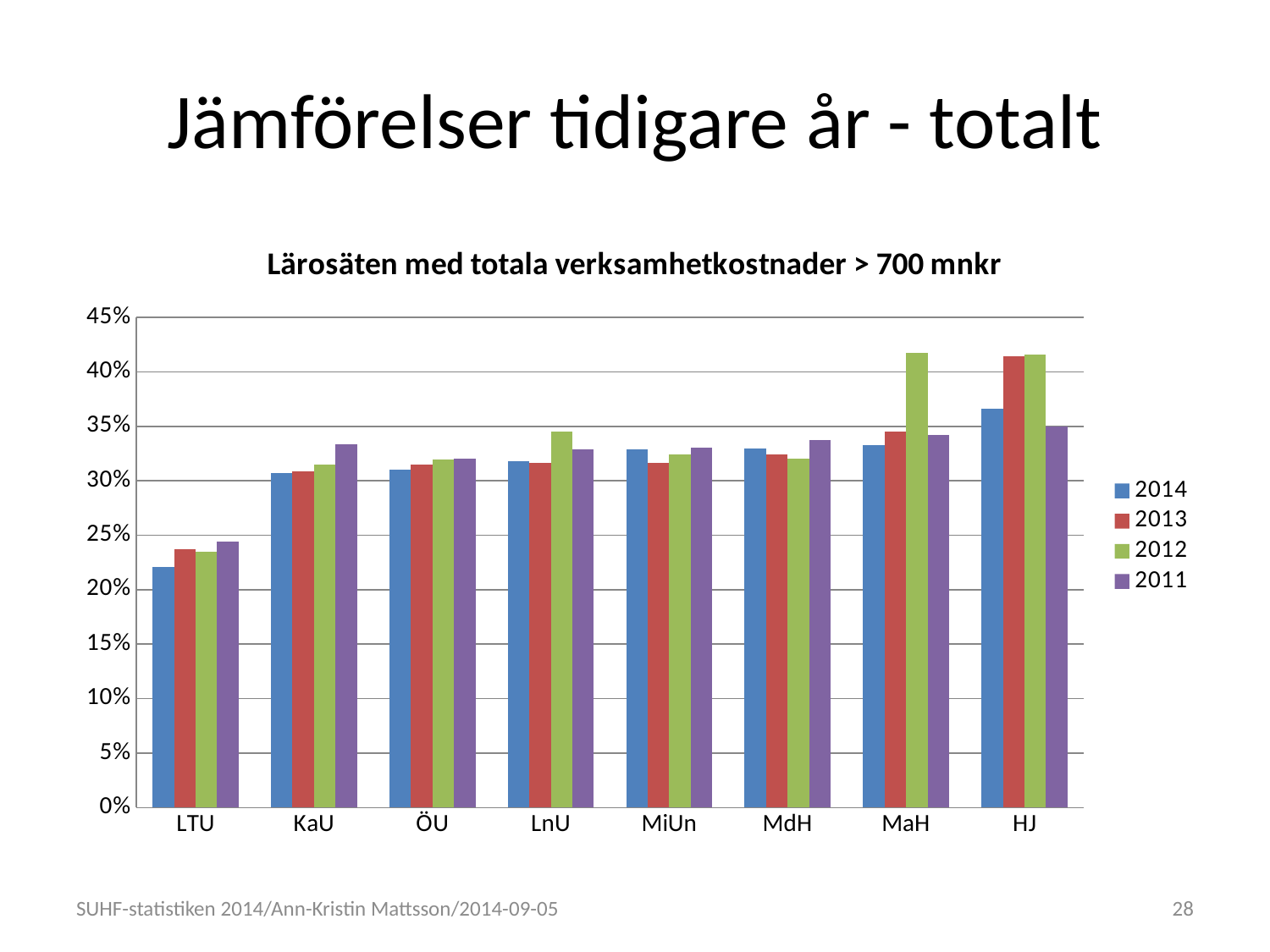
For MaH, which is larger: the 2012 value or the 2013 value? 2012 What is the title of the chart? Lärosäten med totala verksamhetkostnader > 700 mnkr Which institution has the lowest value for 2014? LTU How many institutions (categories) are shown on the x axis of the chart? 8 What kind of chart is shown on the slide? bar chart Is the 2014 value for KaU greater or less than 30%? greater Which institution has the highest value for 2013? HJ How many series does the chart's legend list? 4 Is the 2014 value for LTU greater or less than 25%? less Is the 2012 value for MaH greater or less than 40%? greater Which institution has the highest value for 2014? HJ Which year does the blue series in the legend represent? 2014